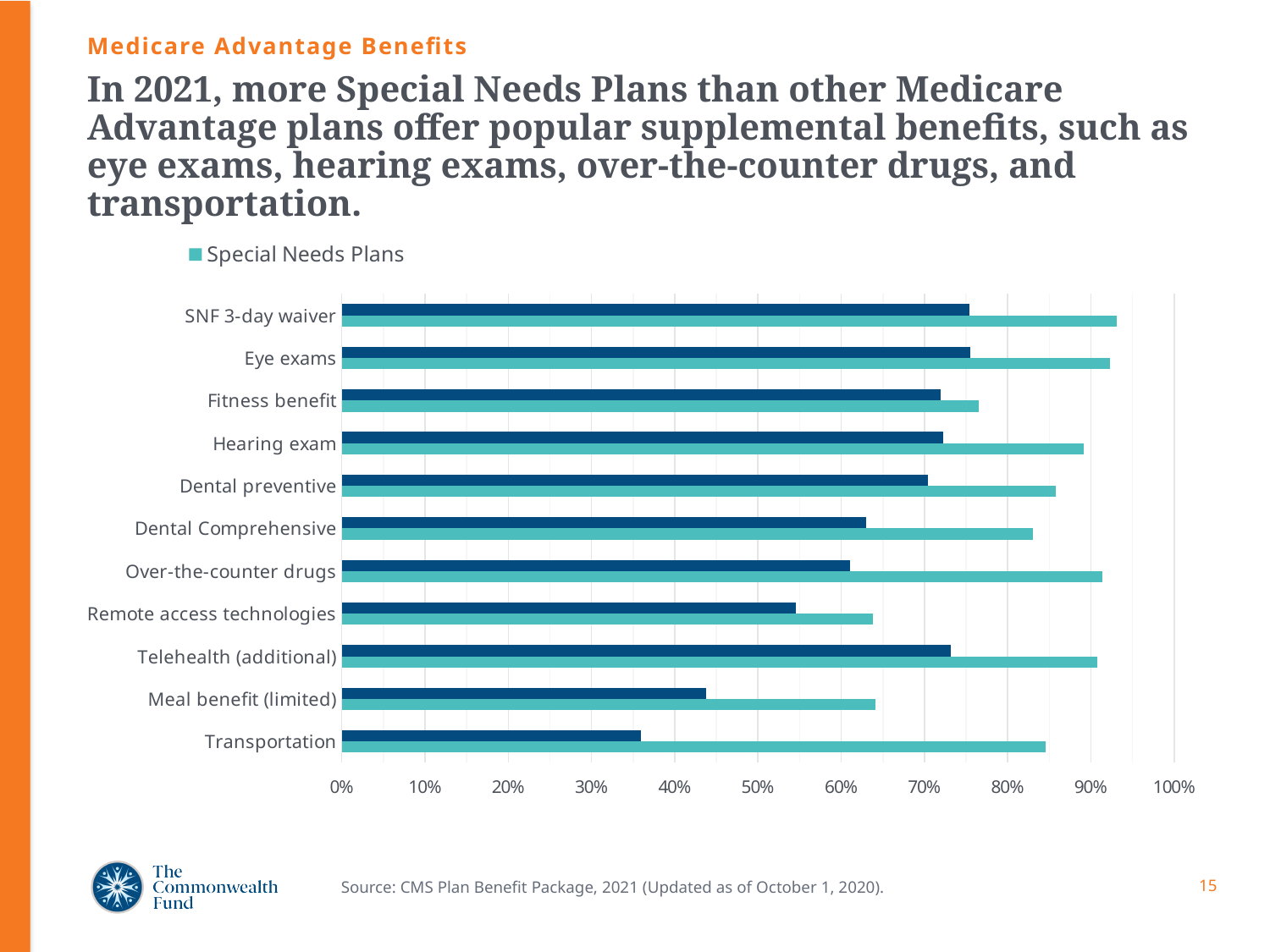
Is the Special Needs Plans value for Transportation greater or less than 80%? greater How many series does the chart legend list? 1 Is the Special Needs Plans value for Eye exams greater or less than 90%? greater How many benefit categories are plotted on the chart? 11 Is the Special Needs Plans value for SNF 3-day waiver greater or less than 90%? greater What kind of chart is shown on the slide? bar chart Which series is named in the chart legend? Special Needs Plans For Special Needs Plans, which is larger: Transportation or Remote access technologies? Transportation Which category has the shortest dark blue bar on the chart? Transportation For Special Needs Plans, which is larger: Hearing exam or Fitness benefit? Hearing exam